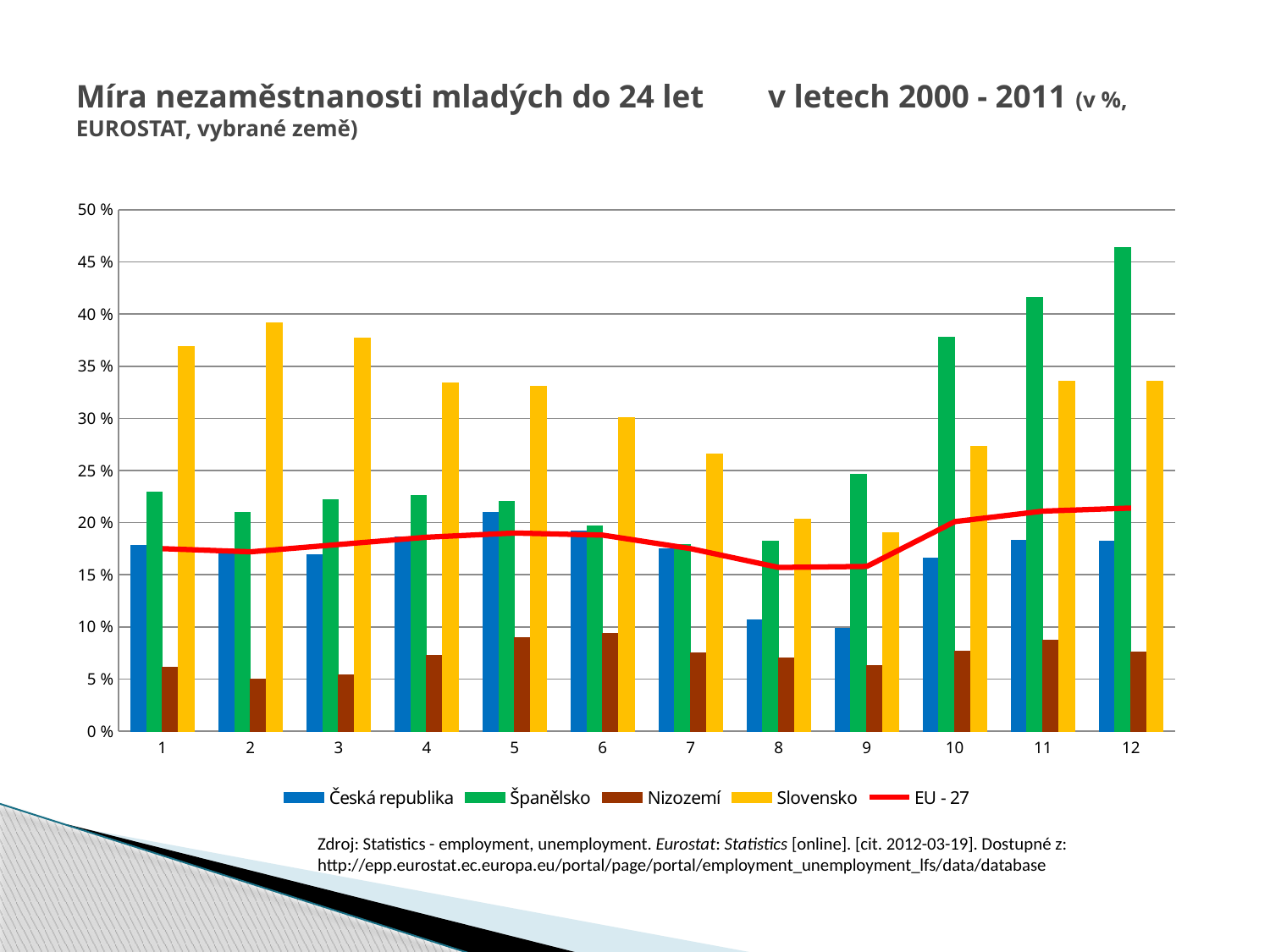
In which category does Španělsko reach its highest value? 12 What kind of chart is shown on the slide? bar chart (with a line series) In category 10, which is larger: Španělsko or Slovensko? Španělsko How many series does the legend list? 5 Is the value for Slovensko in category 7 greater or less than 25 %? greater In which category does Slovensko reach its highest value? 2 Is the value for Španělsko in category 12 greater or less than 45 %? greater Does the EU - 27 line rise or fall from category 8 to category 12? rise Is the value for Nizozemí in category 1 greater or less than 10 %? less In category 1, which is larger: Slovensko or Španělsko? Slovensko In which category does Česká republika reach its highest value? 5 How many categories are shown on the x axis? 12